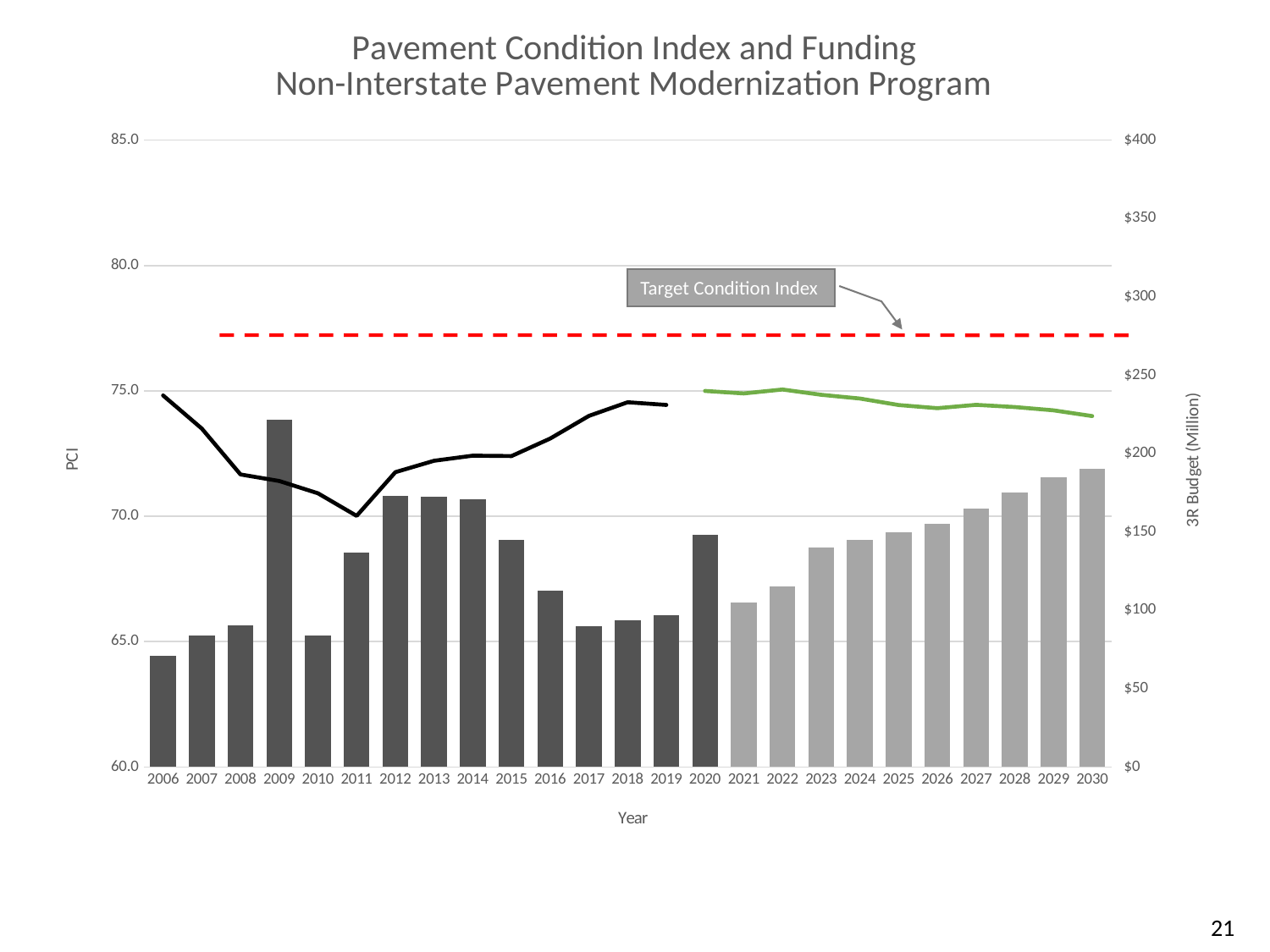
How many years are shown along the x axis of the chart? 25 What kind of chart is shown on the slide? A combination bar and line chart Is the bar for 2028 greater or less than $150 on the right-hand axis? greater Does the black PCI line rise or fall from 2011 to 2018? rise Is the bar for 2006 greater or less than $100 on the right-hand axis? less Is the black PCI line higher in 2006 or in 2011? 2006 Do the bars rise or fall from 2021 to 2030? rise What is the label on the right-hand vertical axis of the chart? 3R Budget (Million) Which year has the tallest bar in the chart? 2009 Which year has the shortest bar in the chart? 2006 Is the bar for 2009 greater or less than $200 on the right-hand axis? greater Is the bar for 2009 taller or shorter than the bar for 2030? taller